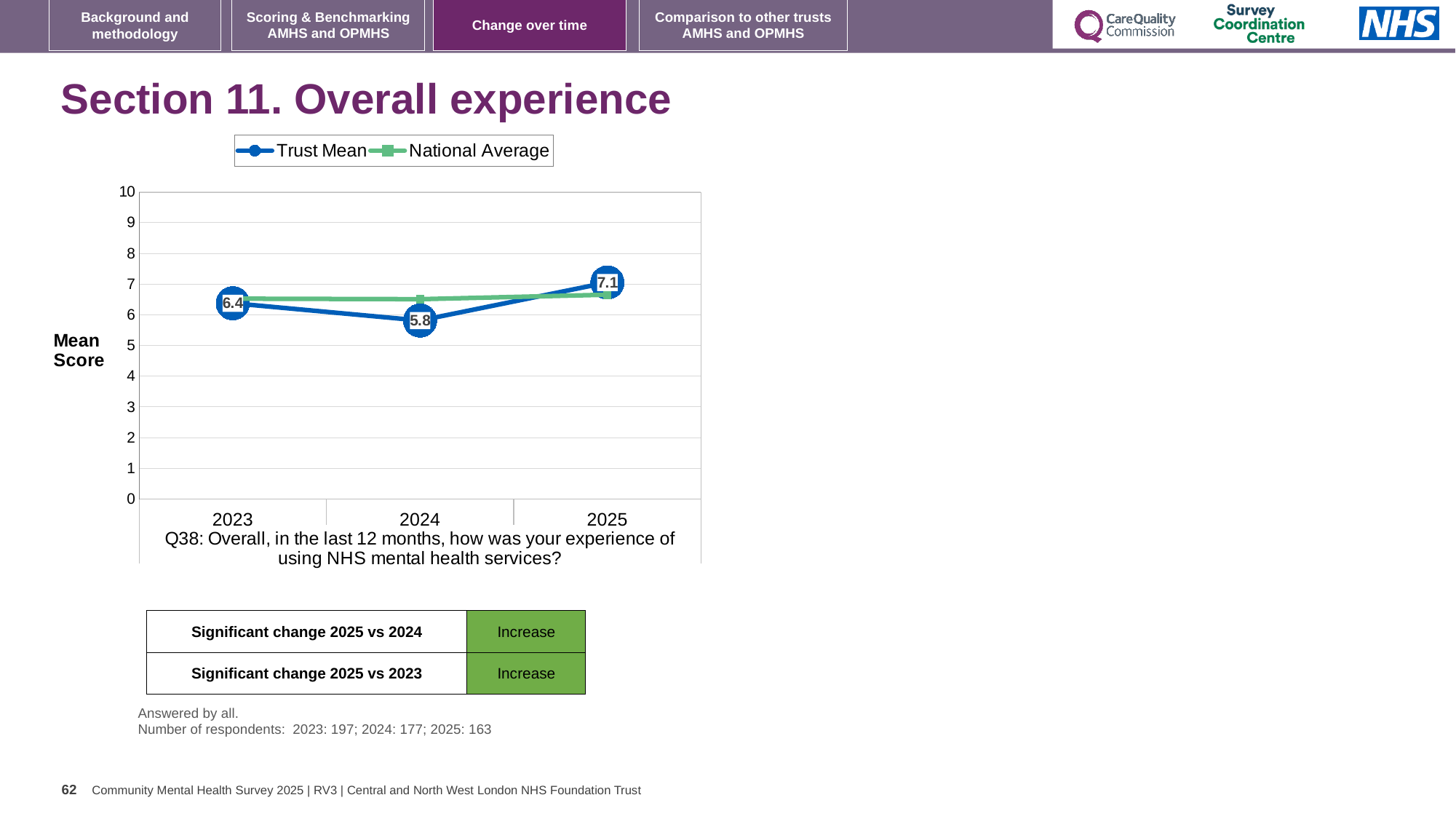
Is the National Average value for 2025 greater or less than 6? greater Does the Trust Mean rise or fall from 2024 to 2025? Rise What kind of chart is shown on the slide? Line chart What is the Trust Mean score for 2024? 5.8 What is the Trust Mean score for 2025? 7.1 In which year is the Trust Mean lowest? 2024 What is the difference between the Trust Mean in 2025 and in 2024? 1.3 How many years are shown on the x axis? 3 What is the Trust Mean score for 2023? 6.4 In which year is the Trust Mean highest? 2025 Which is larger in 2024, the Trust Mean or the National Average? National Average How many series does the legend list? 2